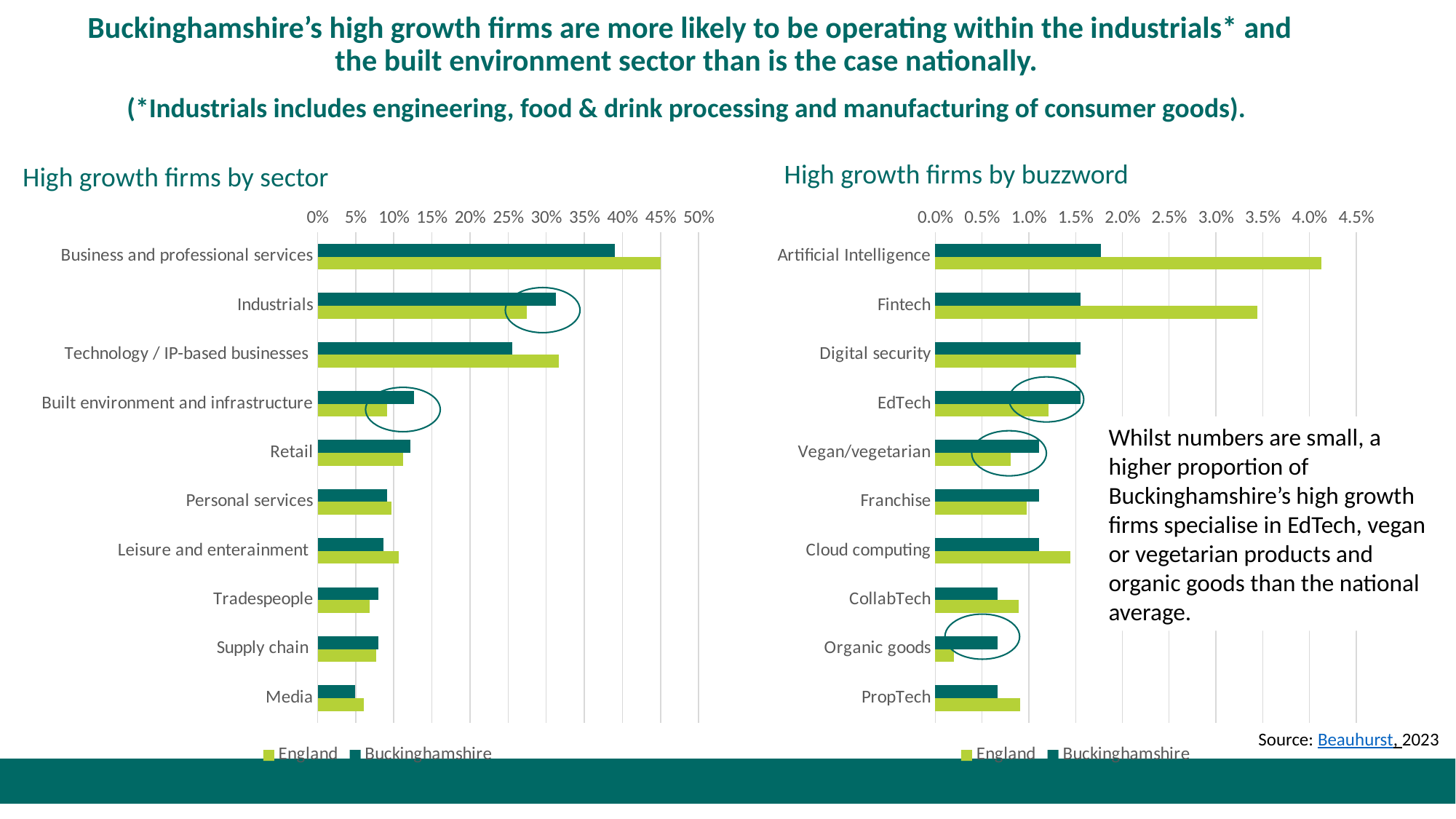
In the 'High growth firms by sector' chart, which sector has the highest England value? Business and professional services In the 'High growth firms by sector' chart, is the Buckinghamshire value for Media greater or less than 10%? less What type of chart is the 'High growth firms by sector' chart? bar chart In the 'High growth firms by buzzword' chart, which buzzword has the highest England value? Artificial Intelligence In the 'High growth firms by sector' chart, for Industrials, which is larger: the England value or the Buckinghamshire value? Buckinghamshire In the 'High growth firms by buzzword' chart, is the England value for Fintech greater or less than 3.0%? greater In the 'High growth firms by sector' chart, is the England value for Business and professional services greater or less than 40%? greater In the 'High growth firms by sector' chart, which sector has the lowest Buckinghamshire value? Media How many series does the legend of the 'High growth firms by buzzword' chart list? 2 How many sectors are shown in the 'High growth firms by sector' chart? 10 In the 'High growth firms by sector' chart, for Technology / IP-based businesses, which is larger: the England value or the Buckinghamshire value? England